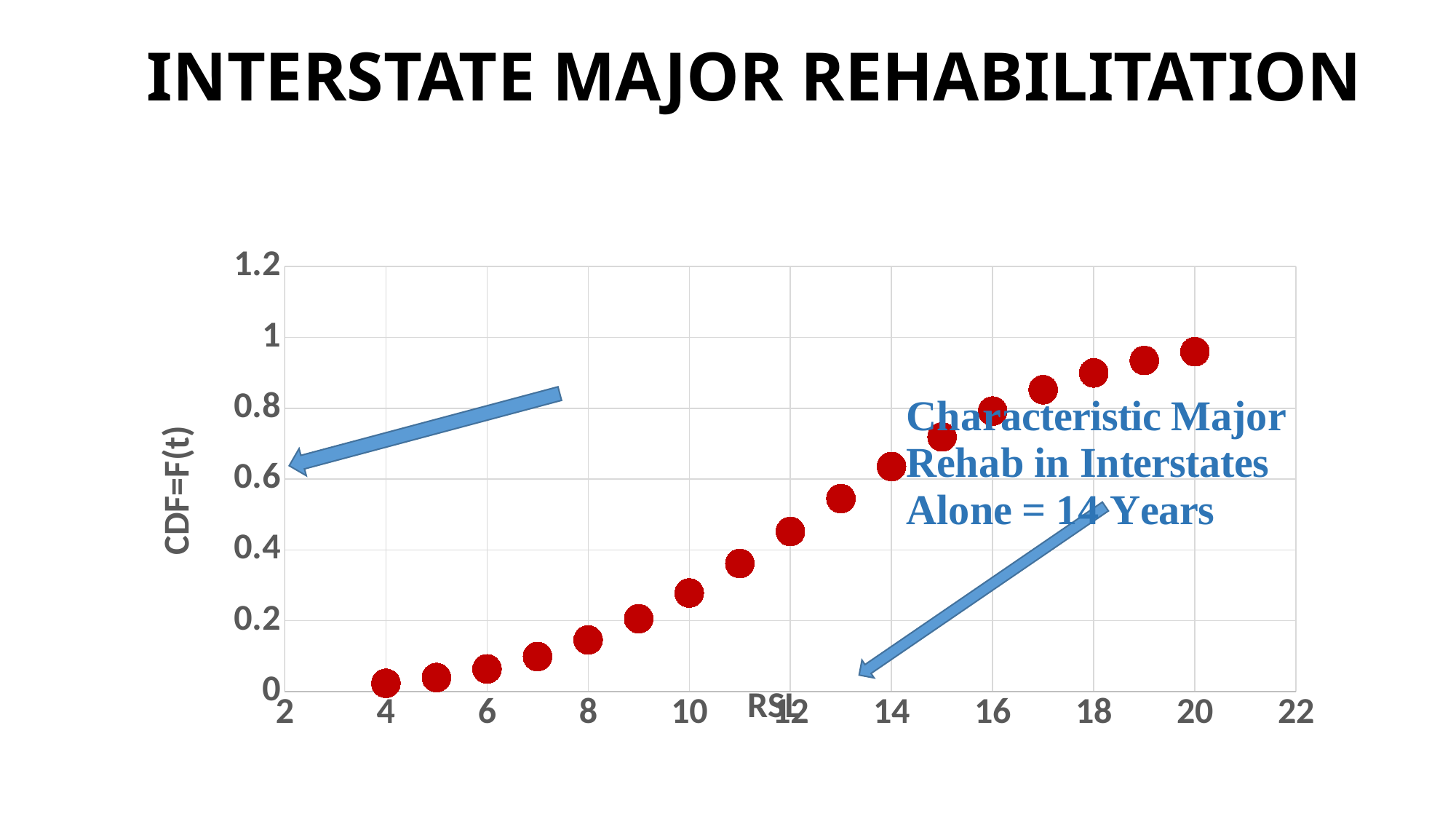
According to the annotation on the chart, how many years is the characteristic major rehab in interstates alone? 14 Years Do the CDF=F(t) values rise or fall as RSL increases along the x axis? rise At which RSL value is CDF=F(t) highest? 20 What kind of chart is shown on the slide? scatter chart What is the label on the y axis of the chart? CDF=F(t) Which has the larger CDF=F(t) value, RSL 10 or RSL 16? RSL 16 Is the CDF=F(t) value at RSL 12 greater or less than 0.4? greater At which RSL value is CDF=F(t) lowest? 4 How many data points are plotted on the chart? 17 Is the CDF=F(t) value at RSL 18 greater or less than 0.8? greater Is the CDF=F(t) value at RSL 8 greater or less than 0.2? less